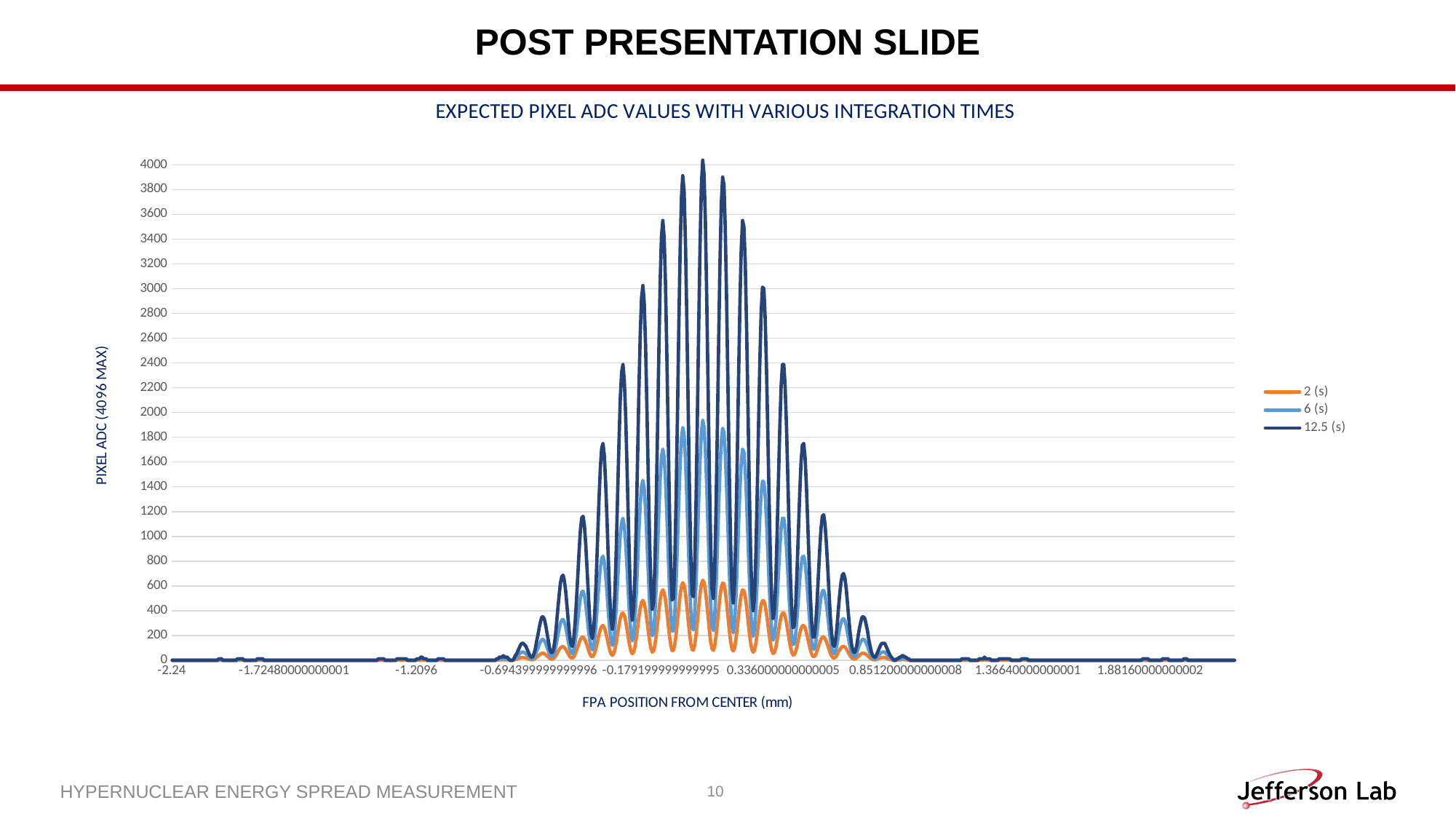
Is the highest peak of the 2 (s) series greater or less than 800? less What kind of chart is shown on the slide? line chart Is the highest peak of the 6 (s) series greater or less than 1600? greater Do the peak values of the 12.5 (s) series rise or fall moving from the center of the x axis toward the right edge? fall What is the label of the vertical axis? PIXEL ADC (4096 MAX) Which series reaches the highest peak value? 12.5 (s) What is the title of the chart? EXPECTED PIXEL ADC VALUES WITH VARIOUS INTEGRATION TIMES How many series does the legend list? 3 Is the highest peak of the 6 (s) series greater or less than 2200? less Which series reaches a higher peak, 6 (s) or 2 (s)? 6 (s) Which series has the lowest peak value? 2 (s)